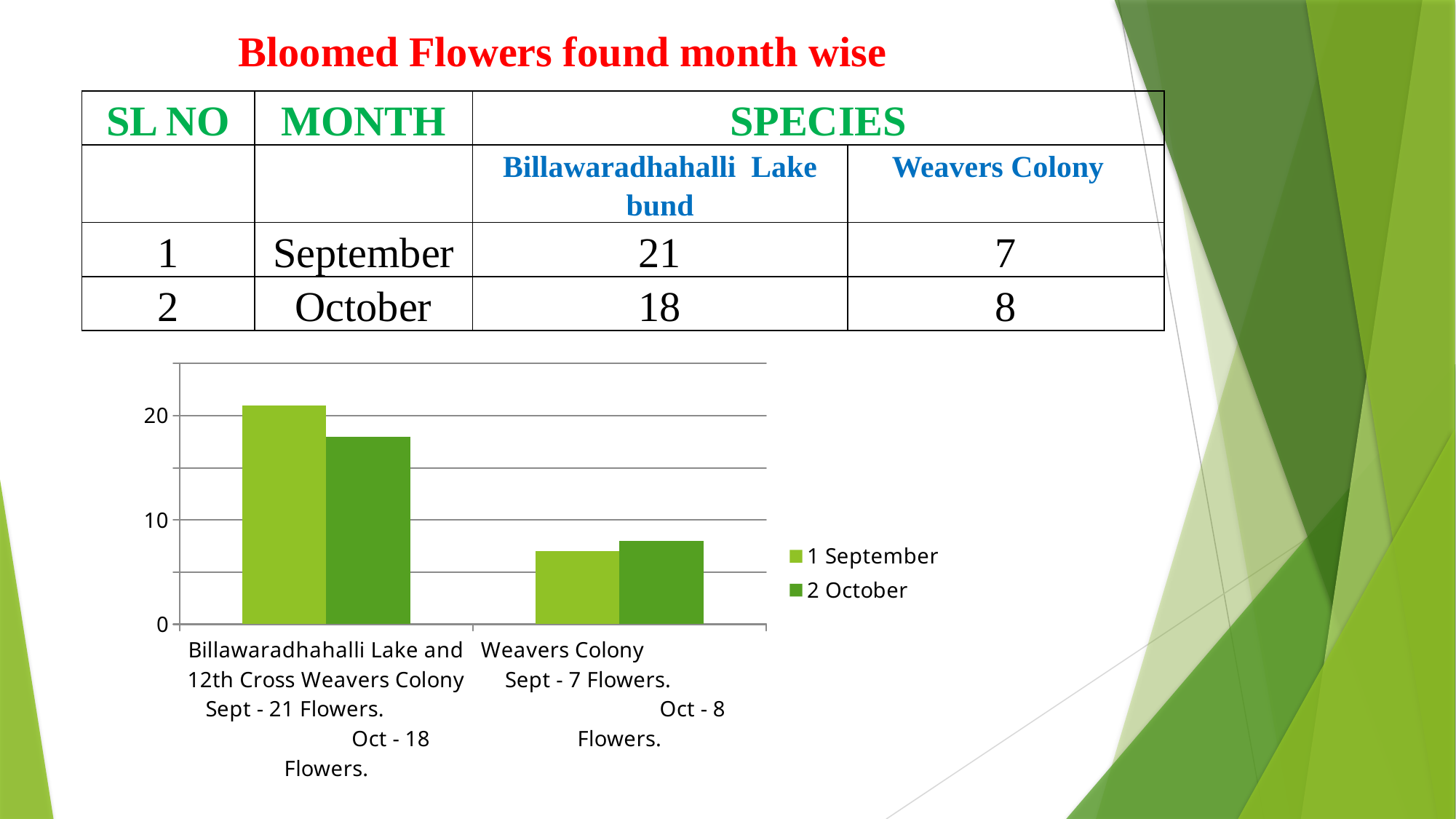
Which category has the highest value in the 1 September series? Billawaradhahalli Lake and 12th Cross Weavers Colony Which category has the lowest value in the 2 October series? Weavers Colony For Weavers Colony, which series has the larger value, 1 September or 2 October? 2 October What is the value of the 2 October series for Weavers Colony? 8 What is the difference between the 1 September and 2 October values for Billawaradhahalli Lake and 12th Cross Weavers Colony? 3 How many series does the chart legend list? 2 How many categories are shown on the x axis of the chart? 2 What is the value of the 1 September series for Weavers Colony? 7 What kind of chart is shown on the slide? bar chart What is the value of the 2 October series for Billawaradhahalli Lake and 12th Cross Weavers Colony? 18 What is the value of the 1 September series for Billawaradhahalli Lake and 12th Cross Weavers Colony? 21 Is the 1 September value for Weavers Colony greater or less than 10? less